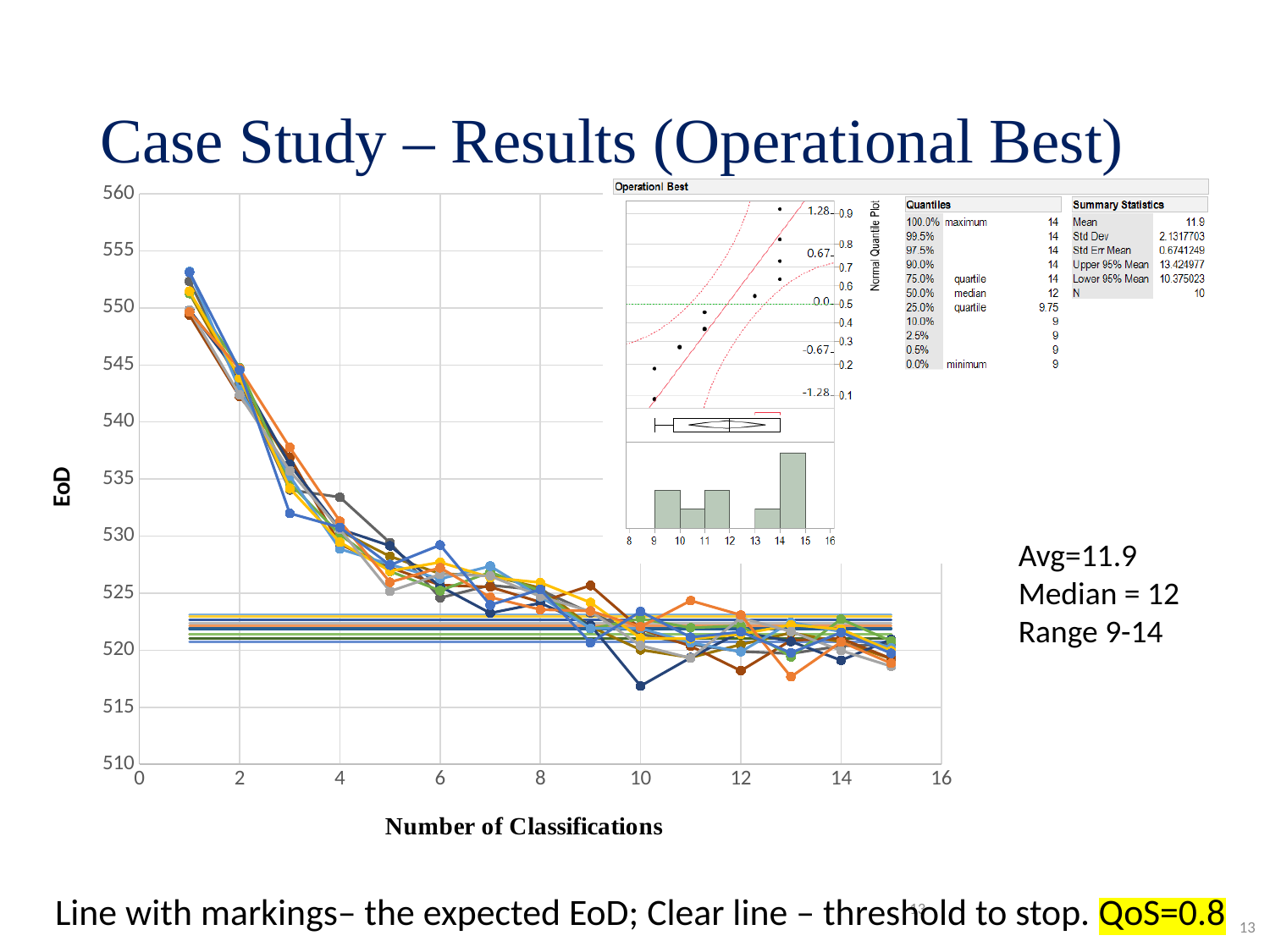
In the large line chart, what is the label of the y axis? EoD In the large line chart, is the EoD value of the marked lines at 1 classification greater or less than 545? greater In the large line chart, is the EoD value of the marked lines at 10 classifications greater or less than 530? less In the large line chart, do the marked lines rise or fall as the number of classifications increases? fall In the Quantiles table of the embedded Operational Best output, what is the median (50.0%)? 12 In the Summary Statistics table of the embedded Operational Best output, what is the Mean? 11.9 In the Summary Statistics table of the embedded Operational Best output, what is N? 10 What kind of chart is the large chart on the left of the slide? line chart In the large line chart, is the EoD value of the marked lines at 3 classifications greater or less than 530? greater In the large line chart, what is the highest value shown on the y axis? 560 In the Quantiles table of the embedded Operational Best output, what is the difference between the maximum and the minimum? 5 In the large line chart, what is the label of the x axis? Number of Classifications